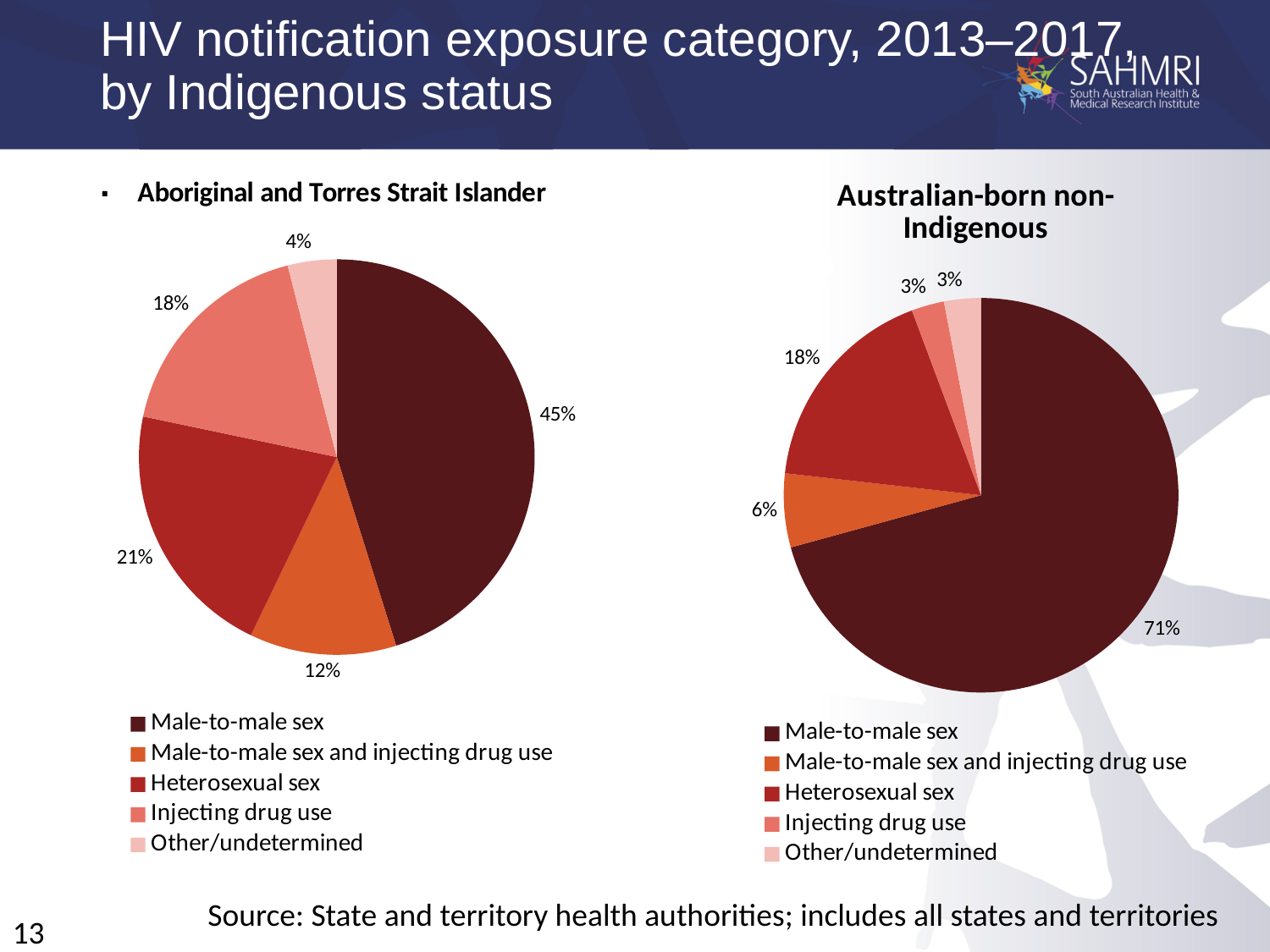
In the Aboriginal and Torres Strait Islander chart, what share is Male-to-male sex? 45% What kind of chart is used for the Aboriginal and Torres Strait Islander data? Pie chart In the Aboriginal and Torres Strait Islander chart, what share is Injecting drug use? 18% Which chart has the larger share for Male-to-male sex and injecting drug use, Aboriginal and Torres Strait Islander or Australian-born non-Indigenous? Aboriginal and Torres Strait Islander What is the difference between the Male-to-male sex share in the Australian-born non-Indigenous chart and in the Aboriginal and Torres Strait Islander chart? 26 percentage points How many exposure categories does the legend of the Australian-born non-Indigenous chart list? 5 In the Australian-born non-Indigenous chart, what share is Male-to-male sex? 71% What is the title of the chart on the right of the slide? Australian-born non-Indigenous In the Australian-born non-Indigenous chart, which exposure category has the largest share? Male-to-male sex In the Aboriginal and Torres Strait Islander chart, which exposure category has the smallest share? Other/undetermined